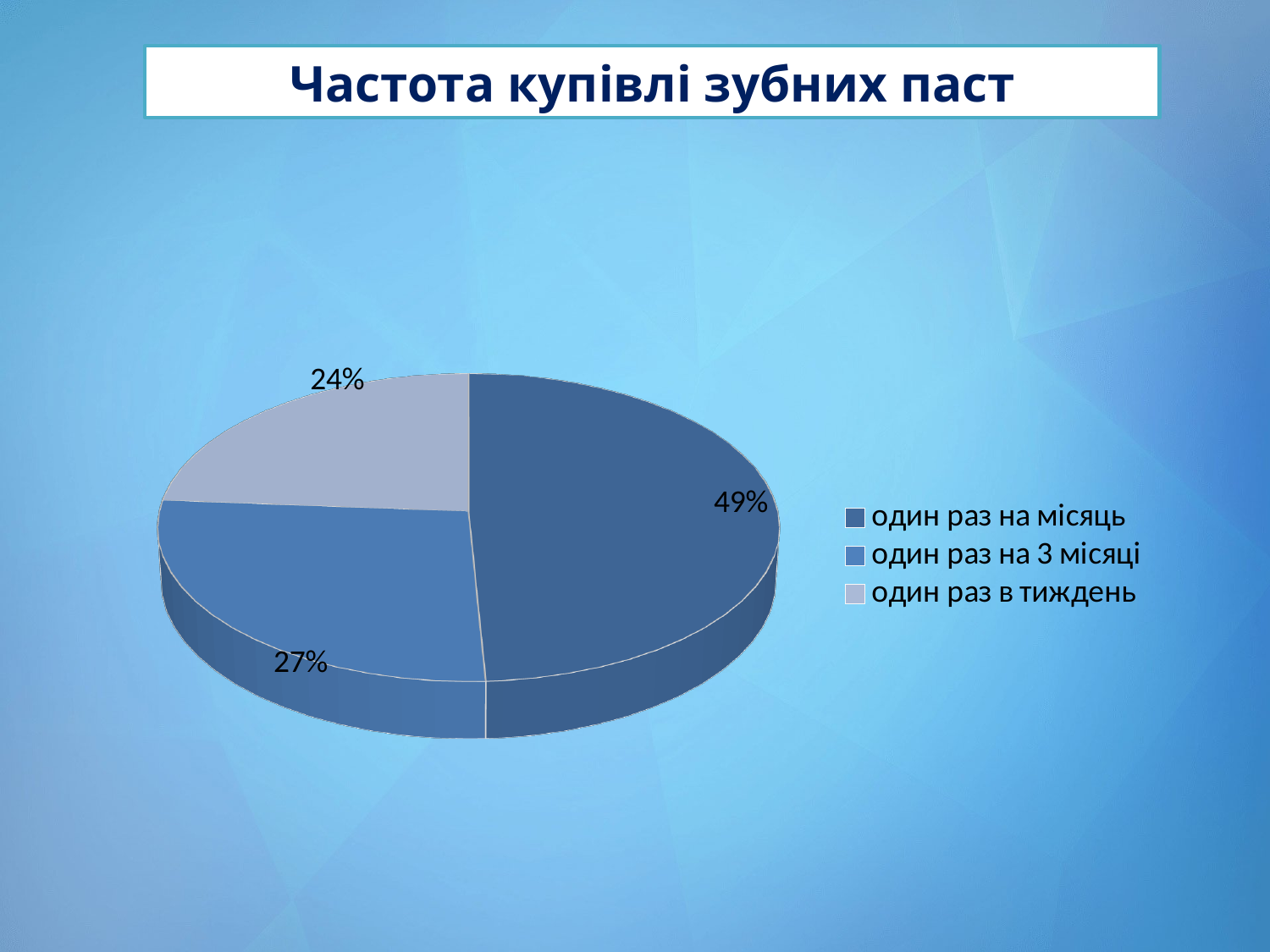
What is the difference in percentage points between the "один раз на 3 місяці" slice and the "один раз в тиждень" slice? 3 Which legend entry is shown with the lightest colour? один раз в тиждень What share of the pie is labelled for "один раз в тиждень"? 24% Which is larger: the slice for "один раз на місяць" or the slice for "один раз на 3 місяці"? один раз на місяць Which category has the largest slice of the pie? один раз на місяць What share of the pie is labelled for "один раз на 3 місяці"? 27% Which category has the smallest slice of the pie? один раз в тиждень What kind of chart is shown on the slide? pie chart What is the title of the chart? Частота купівлі зубних паст What share of the pie is labelled for "один раз на місяць"? 49% What is the difference in percentage points between the "один раз на місяць" slice and the "один раз в тиждень" slice? 25 How many slices does the pie chart have? 3